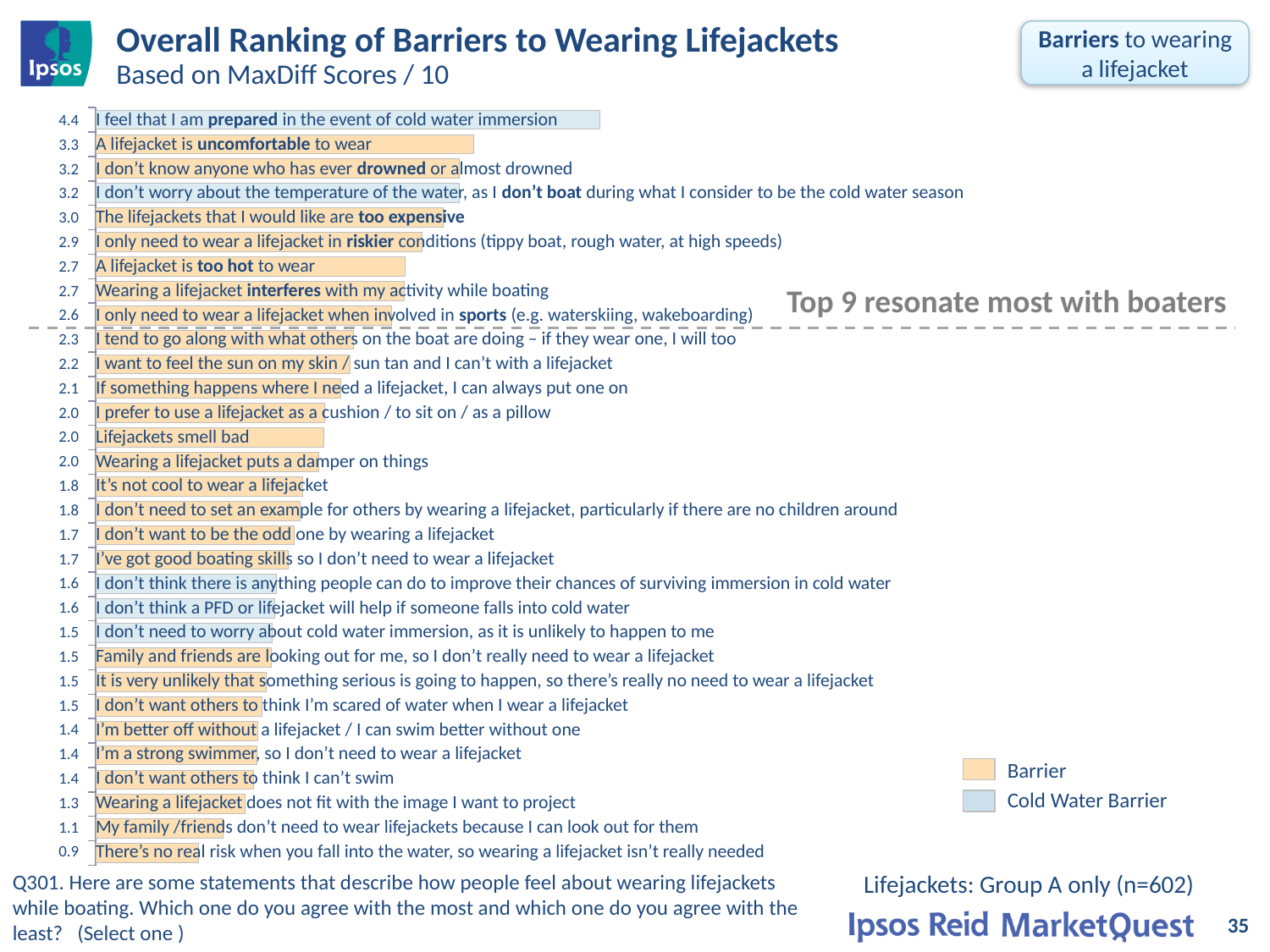
Do the scores increase or decrease going from the top of the chart to the bottom? Decrease How many barrier statements are ranked in the chart? 31 What kind of chart is shown on the slide? Bar chart What score is shown for "I'm a strong swimmer, so I don't need to wear a lifejacket"? 1.4 What is the difference between the score for "I feel that I am prepared in the event of cold water immersion" and the score for "A lifejacket is uncomfortable to wear"? 1.1 What is the MaxDiff score for the barrier "A lifejacket is uncomfortable to wear"? 3.3 Which has the higher score: "A lifejacket is too hot to wear" or "The lifejackets that I would like are too expensive"? The lifejackets that I would like are too expensive How many series does the legend list? 2 Which barrier has the lowest MaxDiff score? There's no real risk when you fall into the water, so wearing a lifejacket isn't really needed Which barrier has the highest MaxDiff score? I feel that I am prepared in the event of cold water immersion What are the two legend entries in the chart? Barrier; Cold Water Barrier What is the score shown for "Lifejackets smell bad"? 2.0